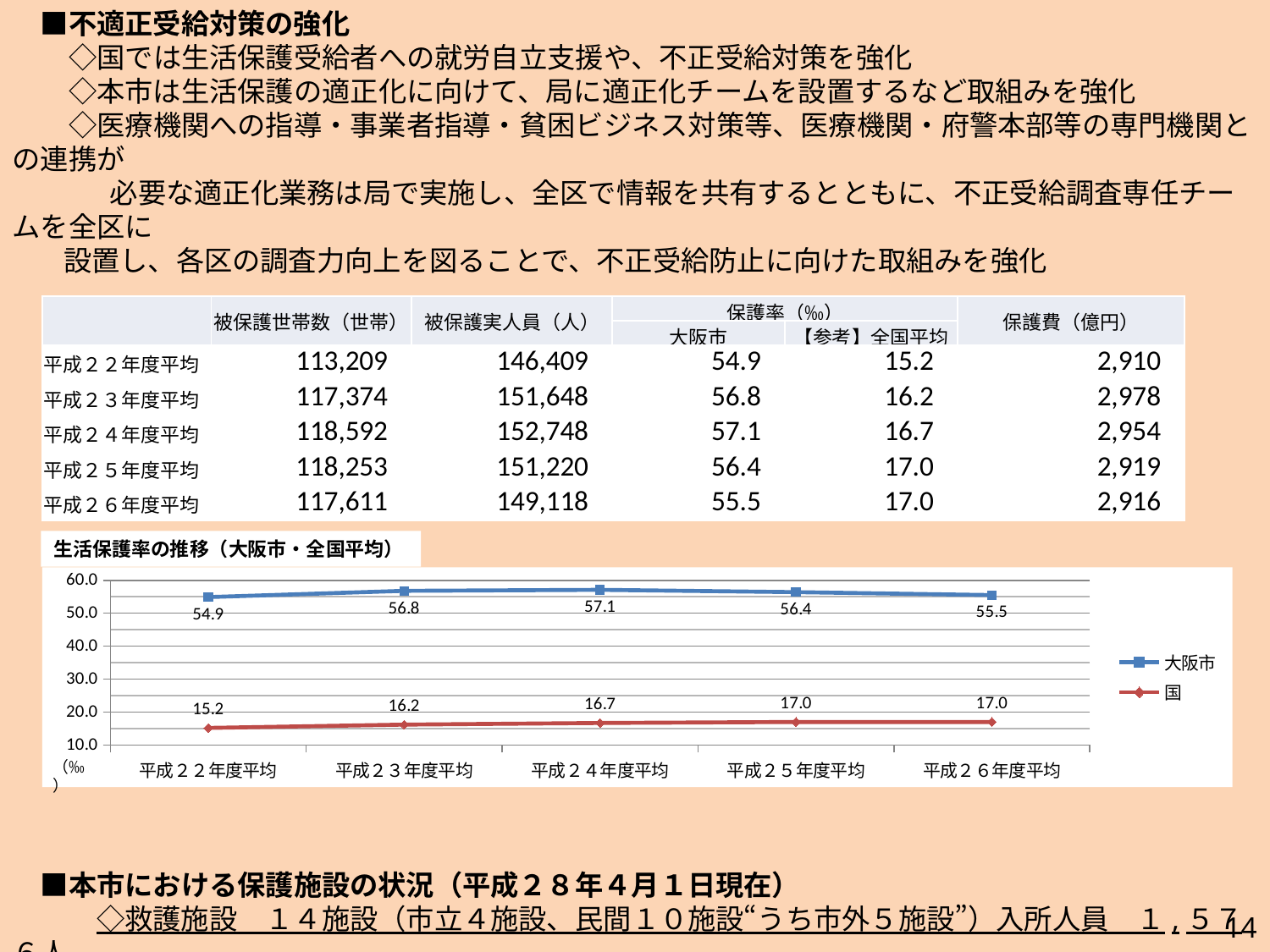
How many years are plotted on the x axis? 5 Which is larger, the 国 value in 平成２３年度平均 or in 平成２４年度平均? 平成２４年度平均 What is the value for 大阪市 in 平成２６年度平均? 55.5 What type of chart is shown on the slide? line chart Does the 国 series rise or fall from 平成２２年度平均 to 平成２５年度平均? rise How many series does the legend list? 2 What is the title of the chart? 生活保護率の推移（大阪市・全国平均） In which year is the 大阪市 value highest? 平成２４年度平均 In which year is the 大阪市 value lowest? 平成２２年度平均 What is the value for 大阪市 in 平成２４年度平均? 57.1 What is the value for 国 in 平成２２年度平均? 15.2 What is the difference between the 大阪市 and 国 values in 平成２５年度平均? 39.4